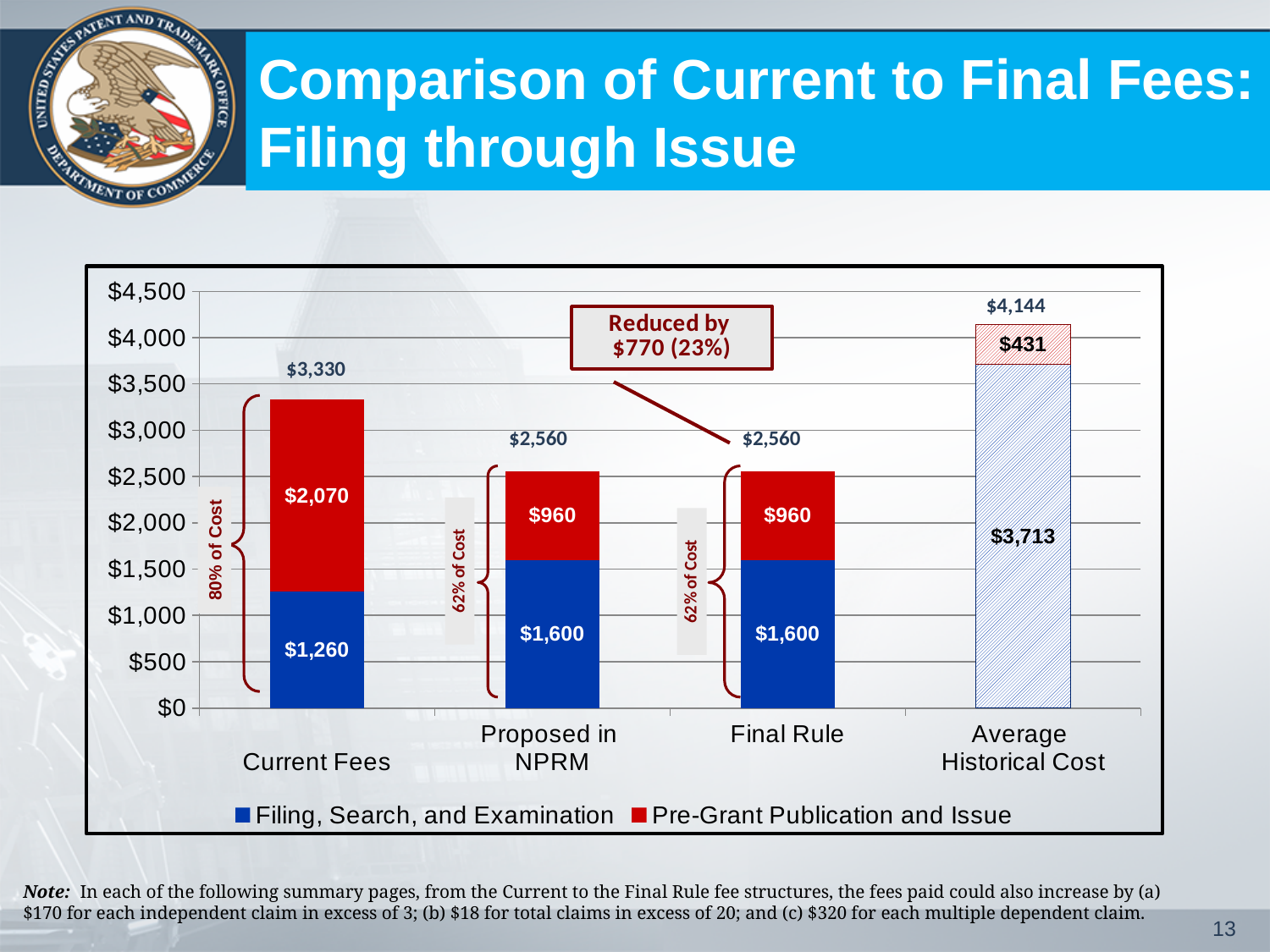
What is the total of the stacked bar for Proposed in NPRM? $2,560 What is the difference between the Current Fees total and the Final Rule total? $770 What kind of chart is shown on the slide? Stacked bar chart Which category has the highest stacked bar total? Average Historical Cost How many series does the legend list? 2 What is the value of Pre-Grant Publication and Issue for Current Fees? $2,070 How many categories are shown on the x axis? 4 What is the value of Pre-Grant Publication and Issue for Average Historical Cost? $431 What is the value of Filing, Search, and Examination for Final Rule? $1,600 Which is larger: Pre-Grant Publication and Issue for Current Fees or for Final Rule? Current Fees What is the total of the stacked bar for Average Historical Cost? $4,144 What is the value of Filing, Search, and Examination for Current Fees? $1,260